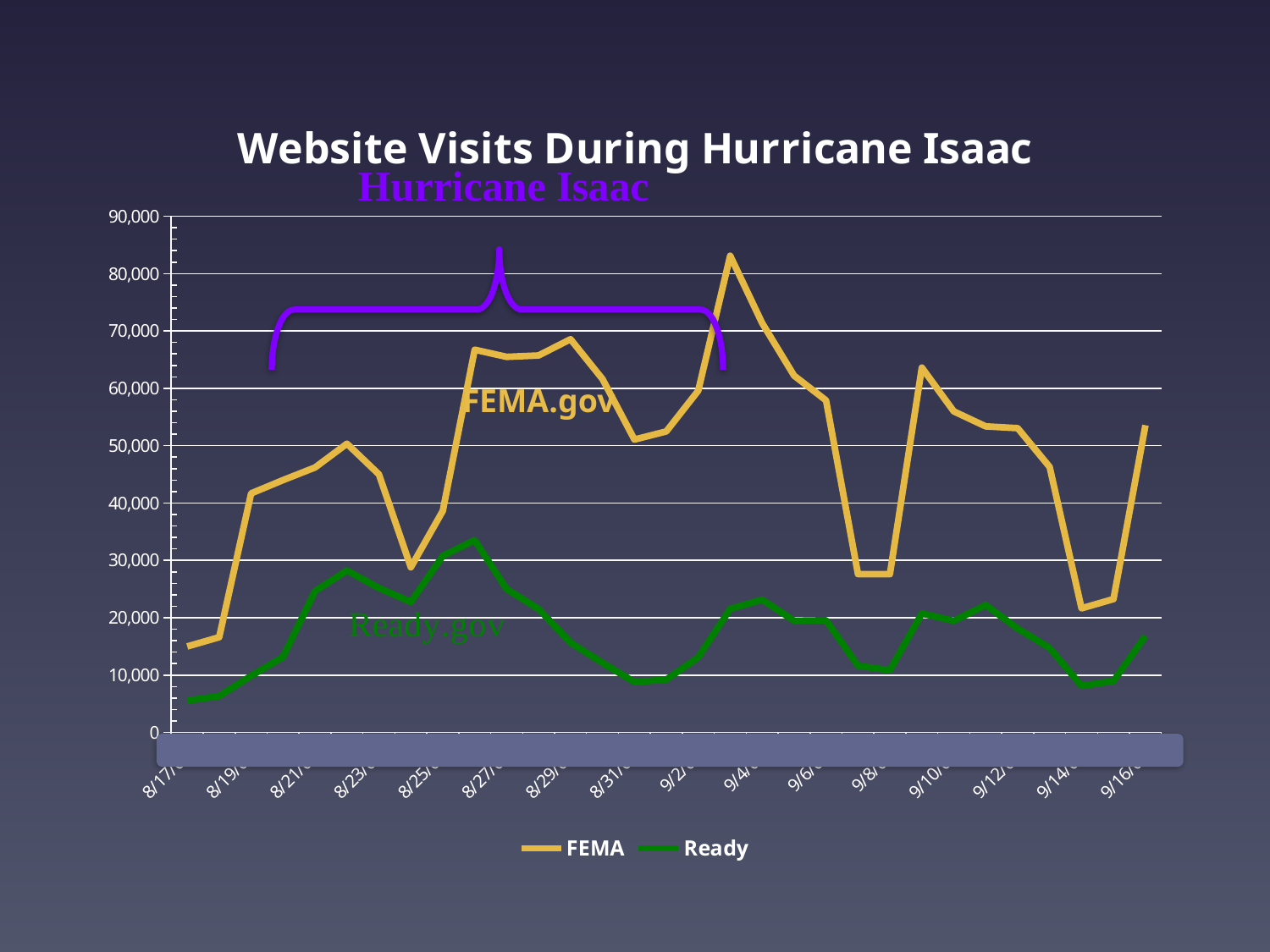
Is the FEMA value on 8/17 greater or less than 20,000? less Which series has the larger value on 8/27, FEMA or Ready? FEMA Is the FEMA value on 9/8 greater or less than 30,000? less Which two series are listed in the legend? FEMA and Ready Does the FEMA line rise or fall between 9/4 and 9/8? Fall What kind of chart is shown on the slide? Line chart What is the title of the chart? Website Visits During Hurricane Isaac How many series does the legend list? 2 Is the FEMA value on 9/4 greater or less than 80,000? less